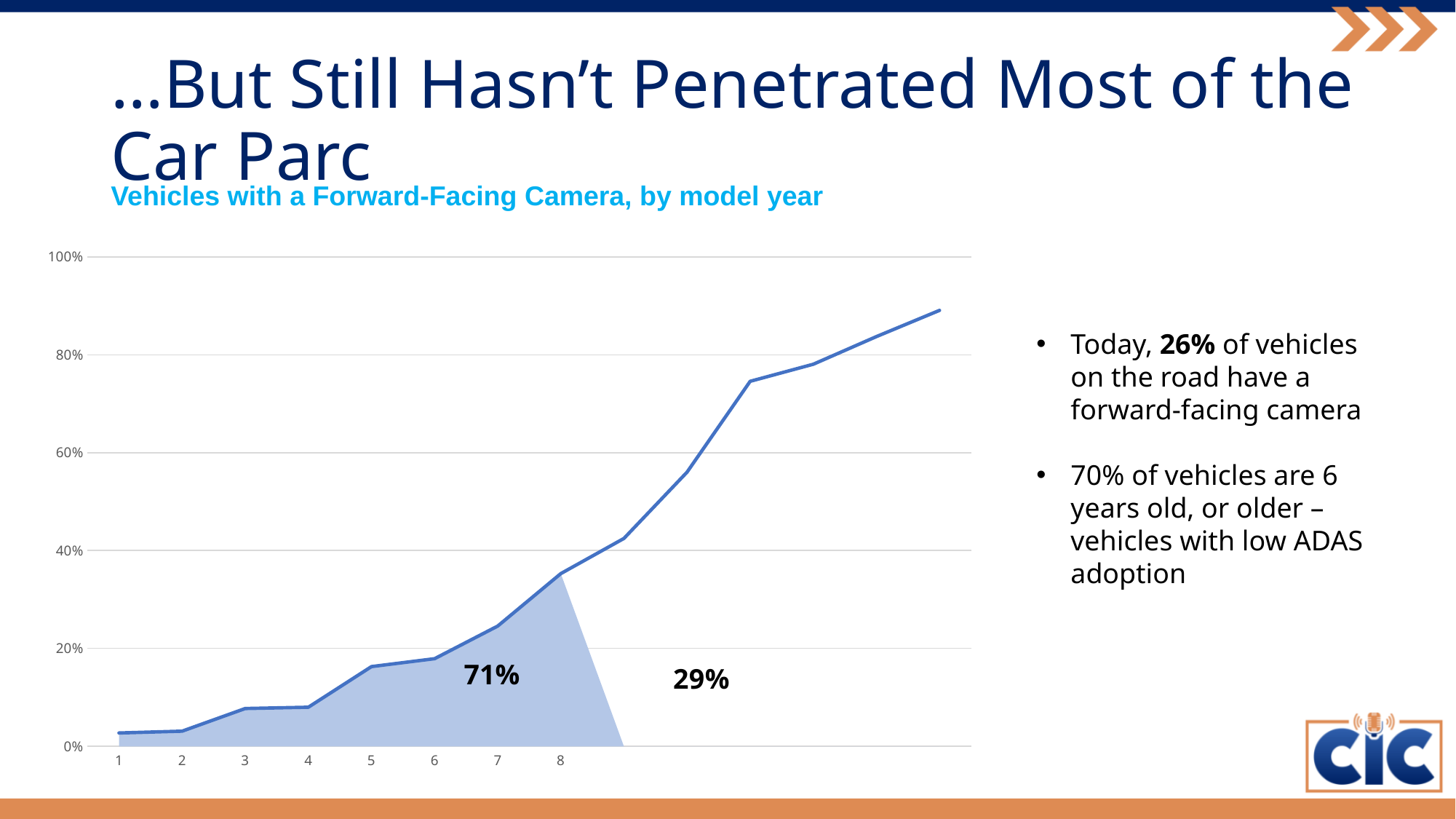
Among the labelled x-axis points 1 to 8, which has the highest value? 8 Which has the larger value, x-axis point 3 or x-axis point 8? 8 Do the values rise or fall as you move from left to right along the x axis? rise Is the value at x-axis point 7 greater or less than 20%? greater What is the highest value shown on the y axis? 100% Is the value at x-axis point 5 greater or less than 20%? less Is the value at x-axis point 8 greater or less than 20%? greater What is the title of the chart? Vehicles with a Forward-Facing Camera, by model year How many labelled points are shown on the x axis? 8 What kind of chart is shown on the slide? line chart